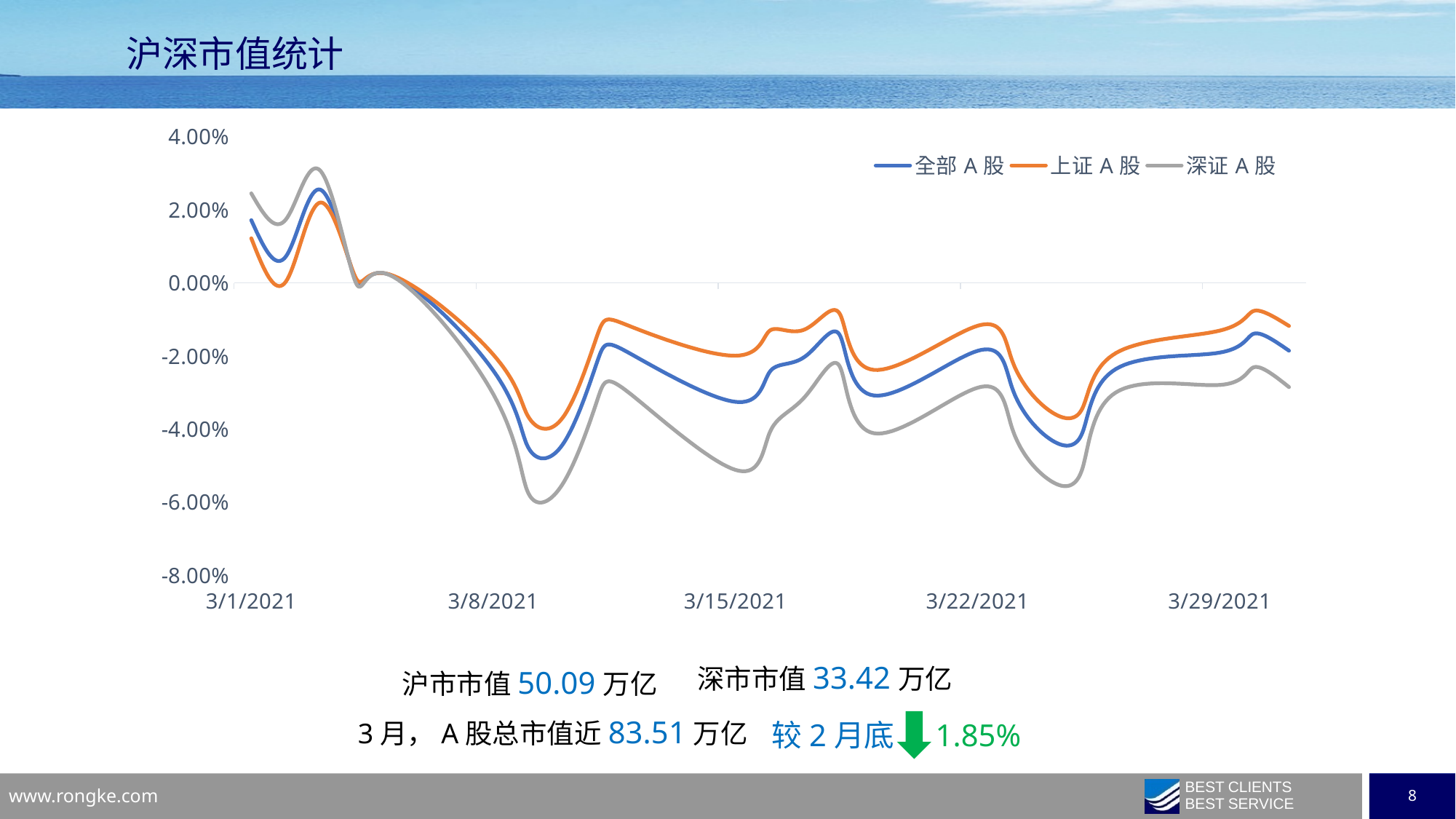
Which series are listed in the chart legend? 全部 A 股, 上证 A 股, 深证 A 股 Is the value of 全部 A 股 at the trough just after 3/8/2021 greater or less than -4.00%? less What kind of chart is shown on the slide? line chart What colour is the line for 深证 A 股? gray Which series reaches the lowest value at the trough just after 3/8/2021? 深证 A 股 Which series has the highest value at the end of the period (after 3/29/2021)? 上证 A 股 How many date labels are shown on the x axis? 5 Overall, do the series values rise or fall from 3/1/2021 to the end of the period? fall How many series does the chart legend list? 3 Is the peak value of 深证 A 股 near the start of the period greater or less than 2.00%? greater Is the lowest value of 深证 A 股 just after 3/8/2021 greater or less than -4.00%? less